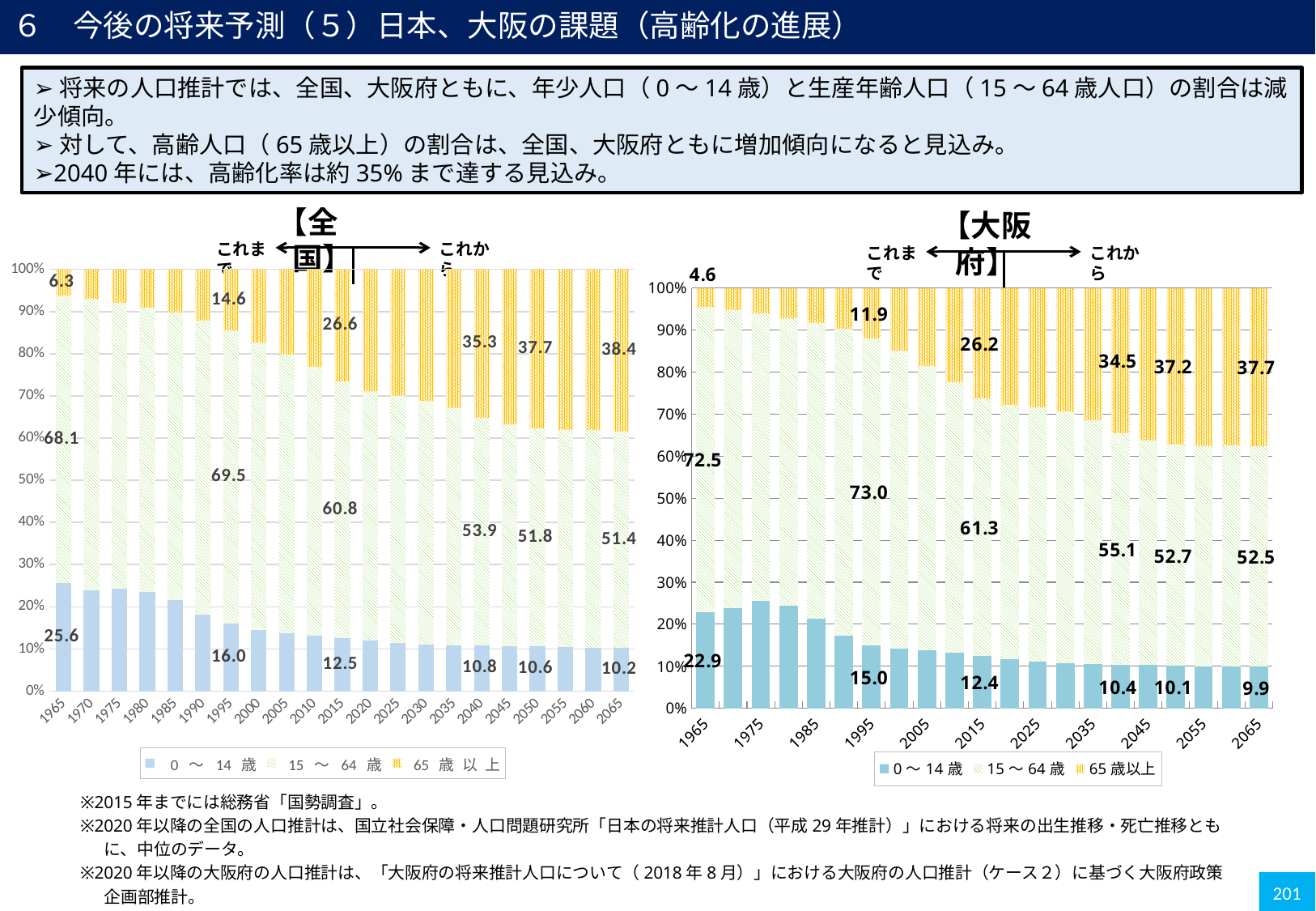
【大阪府】のグラフで、1995年と2065年の0～14歳の割合の差はいくつですか？ 5.1 【大阪府】のグラフで、ラベルが表示されている年のうち、0～14歳の割合が最も高いのは何年ですか？ 1965 2065年の65歳以上の割合は、【全国】と【大阪府】のどちらが大きいですか？ 全国 【大阪府】のグラフで、2015年の15～64歳の割合はいくつですか？ 61.3 【大阪府】のグラフで、1965年の65歳以上の割合はいくつですか？ 4.6 【全国】のグラフで、65歳以上の割合は1965年から2065年にかけて増加していますか、減少していますか？ 増加 【大阪府】のグラフの凡例には、いくつの系列がありますか？ 3 【全国】のグラフで、2065年の65歳以上の割合はいくつですか？ 38.4 【全国】のグラフで、2015年と2065年の65歳以上の割合の差はいくつですか？ 11.8 【全国】のグラフで、1965年の0～14歳の割合はいくつですか？ 25.6 【全国】のグラフの横軸には、いくつの年が表示されていますか？ 21 【全国】のグラフは、どの種類のグラフですか？ 積み上げ棒グラフ